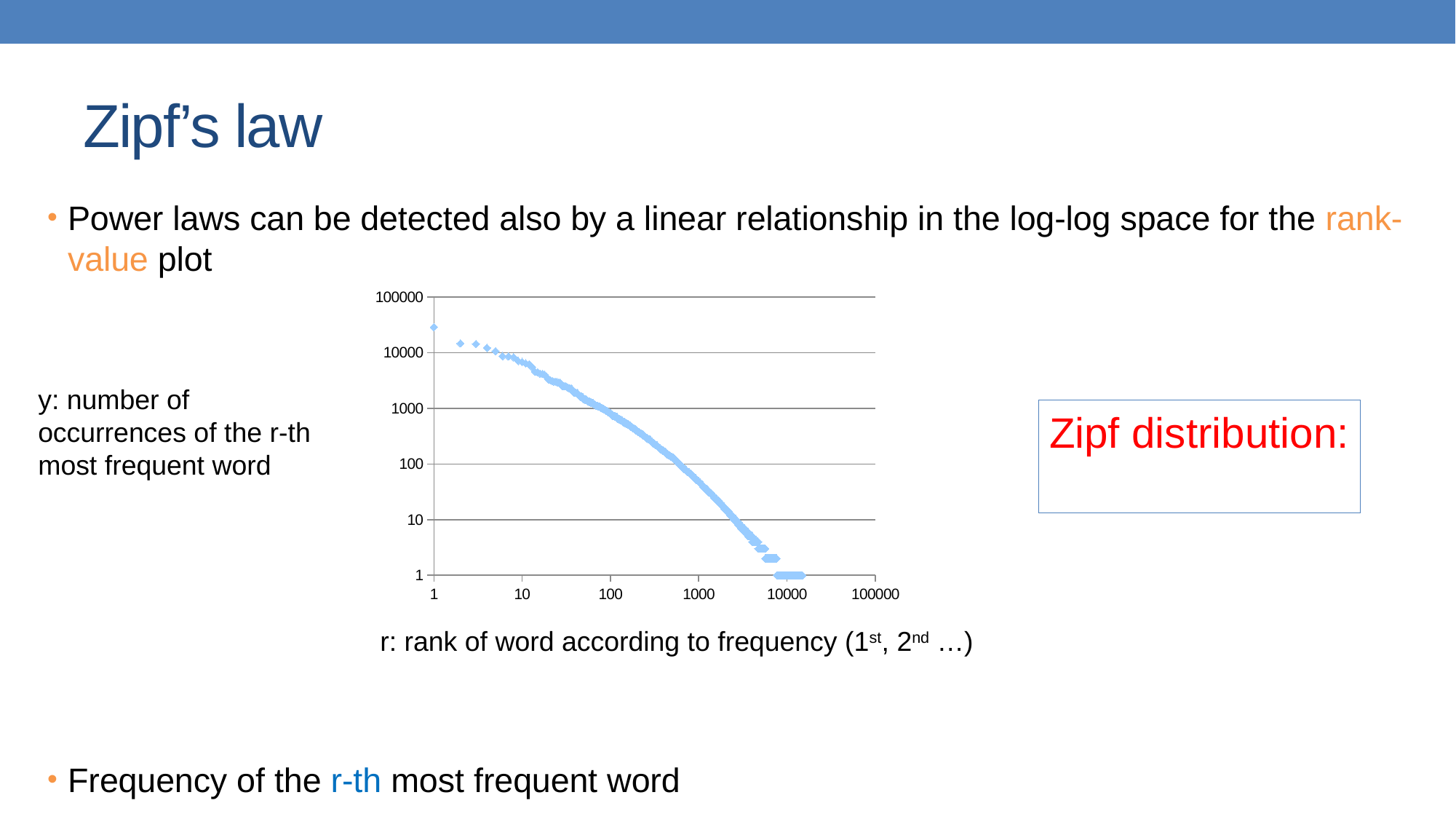
Is the value plotted at rank 100 greater or less than 100? greater Is the value plotted at rank 10 greater or less than 1000? greater Is the value plotted at rank 1 greater or less than 100000? less At which rank on the x axis does the chart reach its highest value? 1 What is the highest tick label shown on the y axis? 100000 What is the lowest tick label shown on the x axis? 1 Is the value plotted at rank 1 larger or smaller than the value plotted at rank 1000? larger Do the plotted values rise or fall as the rank increases along the x axis? fall What kind of chart is shown on the slide? scatter chart